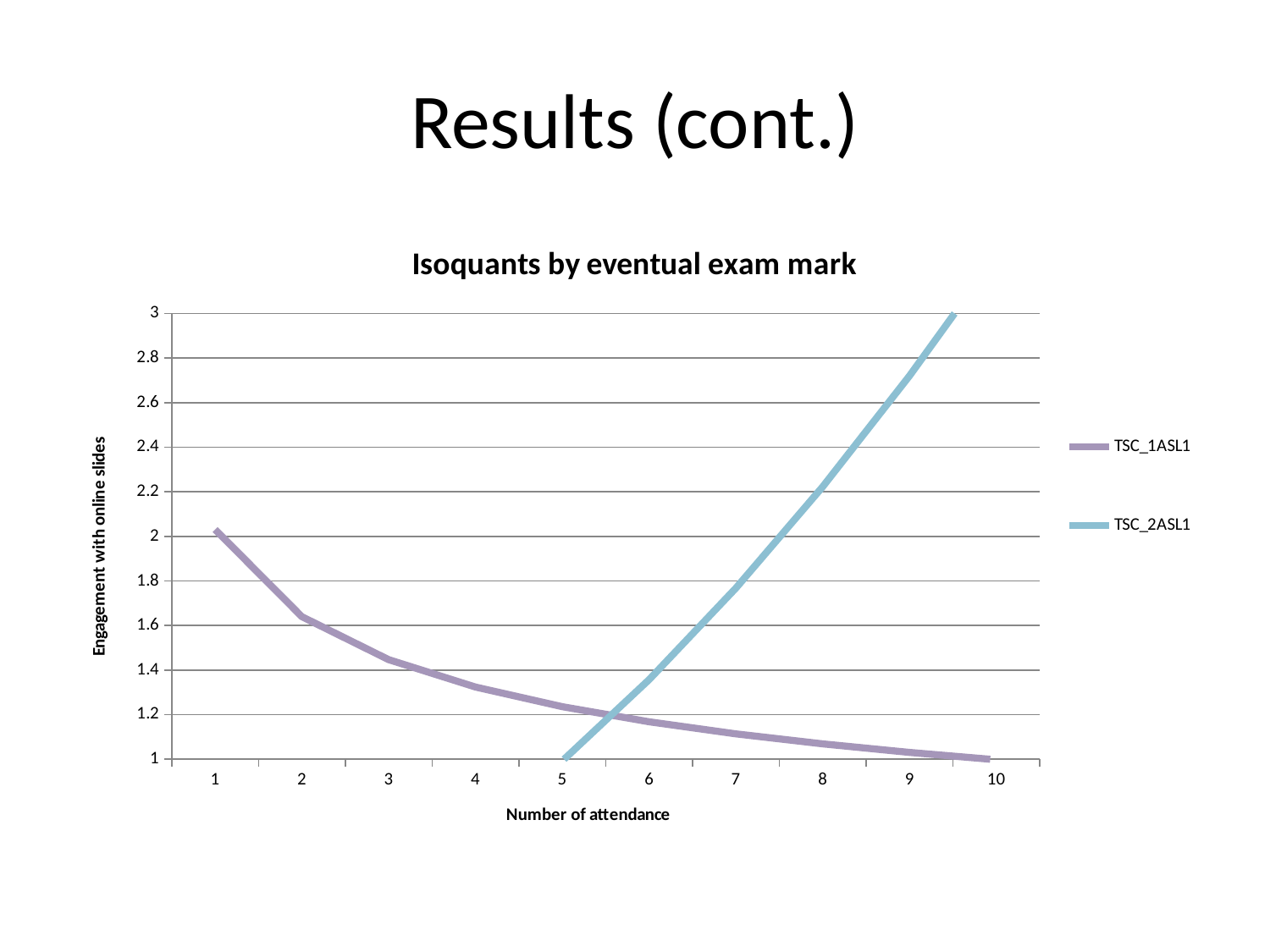
What is the label of the vertical axis? Engagement with online slides What kind of chart is shown on the slide? line chart Does the TSC_1ASL1 line rise or fall as the number of attendance increases? fall Is the value of TSC_1ASL1 at a number of attendance of 8 greater or less than 1.4? less At a number of attendance of 8, which series has the higher value, TSC_1ASL1 or TSC_2ASL1? TSC_2ASL1 How many tick labels are shown on the horizontal axis? 10 Does the TSC_2ASL1 line rise or fall as the number of attendance increases? rise What is the title of the chart? Isoquants by eventual exam mark How many series does the legend list? 2 Is the value of TSC_2ASL1 at a number of attendance of 9 greater or less than 2.6? greater Is the value of TSC_1ASL1 at a number of attendance of 3 greater or less than 1.4? greater Which series reaches the highest value on the chart? TSC_2ASL1